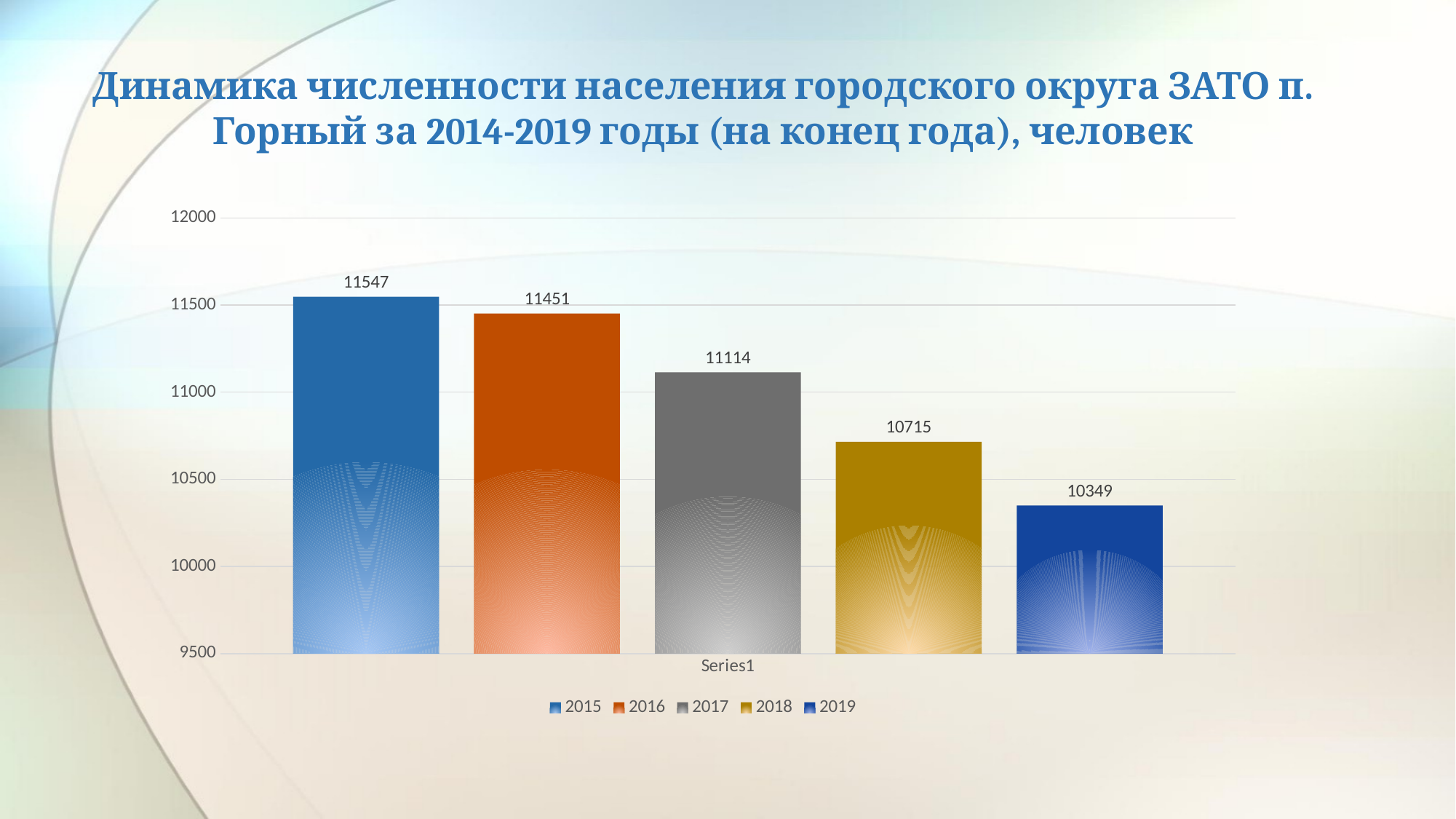
Which is larger, the value for 2018 or the value for 2019? 2018 Which year has the highest population value? 2015 What kind of chart is shown on the slide? bar chart What is the difference between the values for 2016 and 2017? 337 Which year has the lowest population value? 2019 What is the population value shown for 2015? 11547 How many series does the legend list? 5 What is the population value shown for 2019? 10349 Do the values rise or fall from 2015 to 2019? fall What is the population value shown for 2017? 11114 Is the value for 2018 greater or less than 11000? less What is the difference between the values for 2015 and 2019? 1198